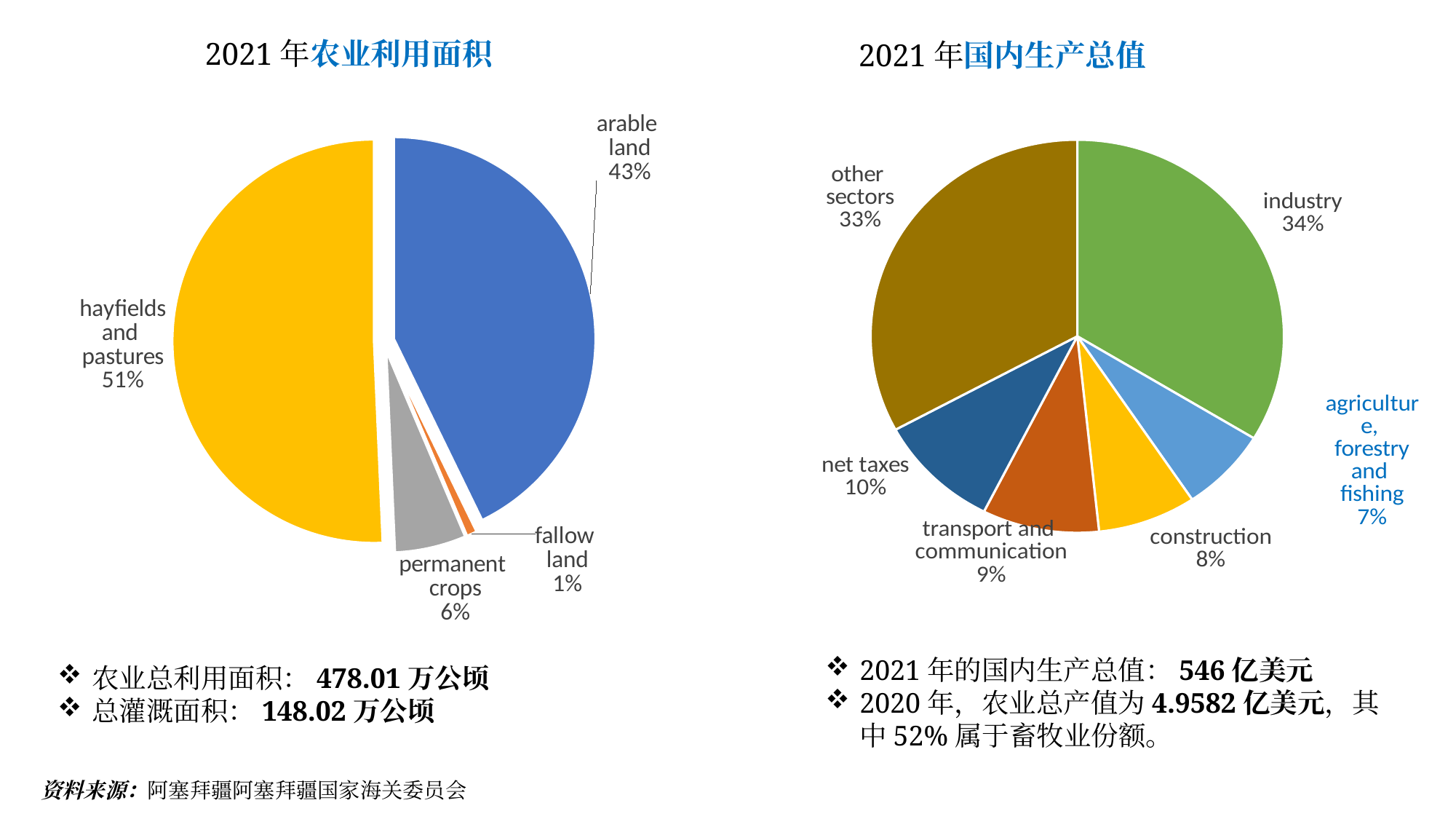
In the left chart (2021 年农业利用面积), what is the difference in percentage points between hayfields and pastures and arable land? 8 In the right chart (2021 年国内生产总值), what share of the pie is net taxes? 10% In the right chart (2021 年国内生产总值), which is larger, construction or transport and communication? transport and communication In the left chart (2021 年农业利用面积), what share of the pie is hayfields and pastures? 51% In the right chart (2021 年国内生产总值), which category has the largest slice? industry In the left chart (2021 年农业利用面积), what share of the pie is arable land? 43% What kind of chart is the left chart (2021 年农业利用面积)? pie chart In the right chart (2021 年国内生产总值), which category has the smallest slice? agriculture, forestry and fishing In the right chart (2021 年国内生产总值), how many slices does the pie have? 6 In the left chart (2021 年农业利用面积), which category has the smallest slice? fallow land In the left chart (2021 年农业利用面积), how many slices does the pie have? 4